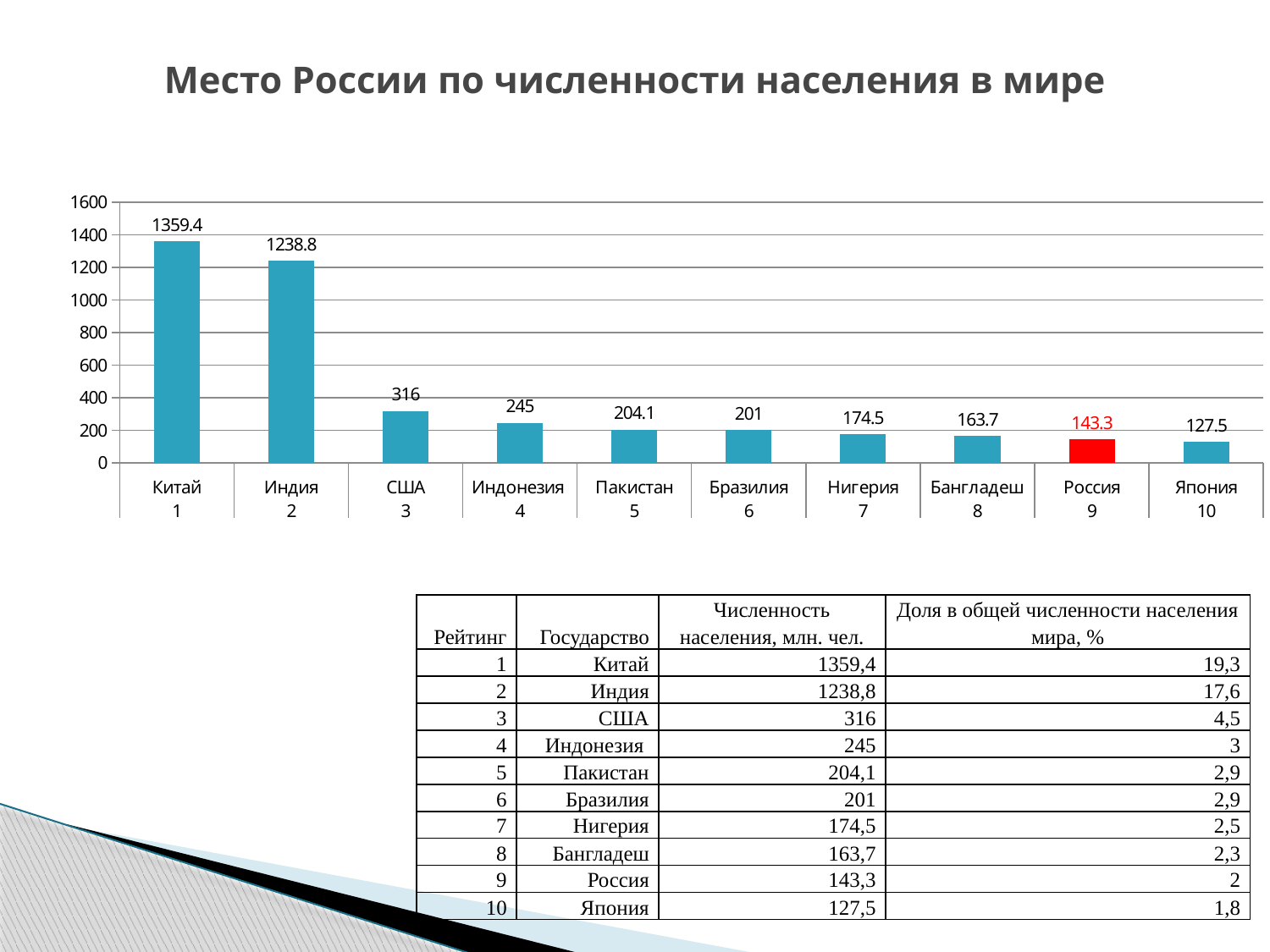
How many countries are shown on the chart? 10 What kind of chart is shown on the slide? bar chart What is the value shown for Китай on the chart? 1359.4 Which country has the highest bar on the chart? Китай What is the value shown for Россия on the chart? 143.3 Which bar on the chart is coloured red instead of blue? Россия Which is larger, the value for США or the value for Индонезия? США What is the difference between the values for Китай and Индия? 120.6 What is the value shown for Индонезия on the chart? 245 What is the difference between the values for Россия and Япония? 15.8 Is the value for Индия greater or less than 1200? greater Which country has the lowest bar on the chart? Япония